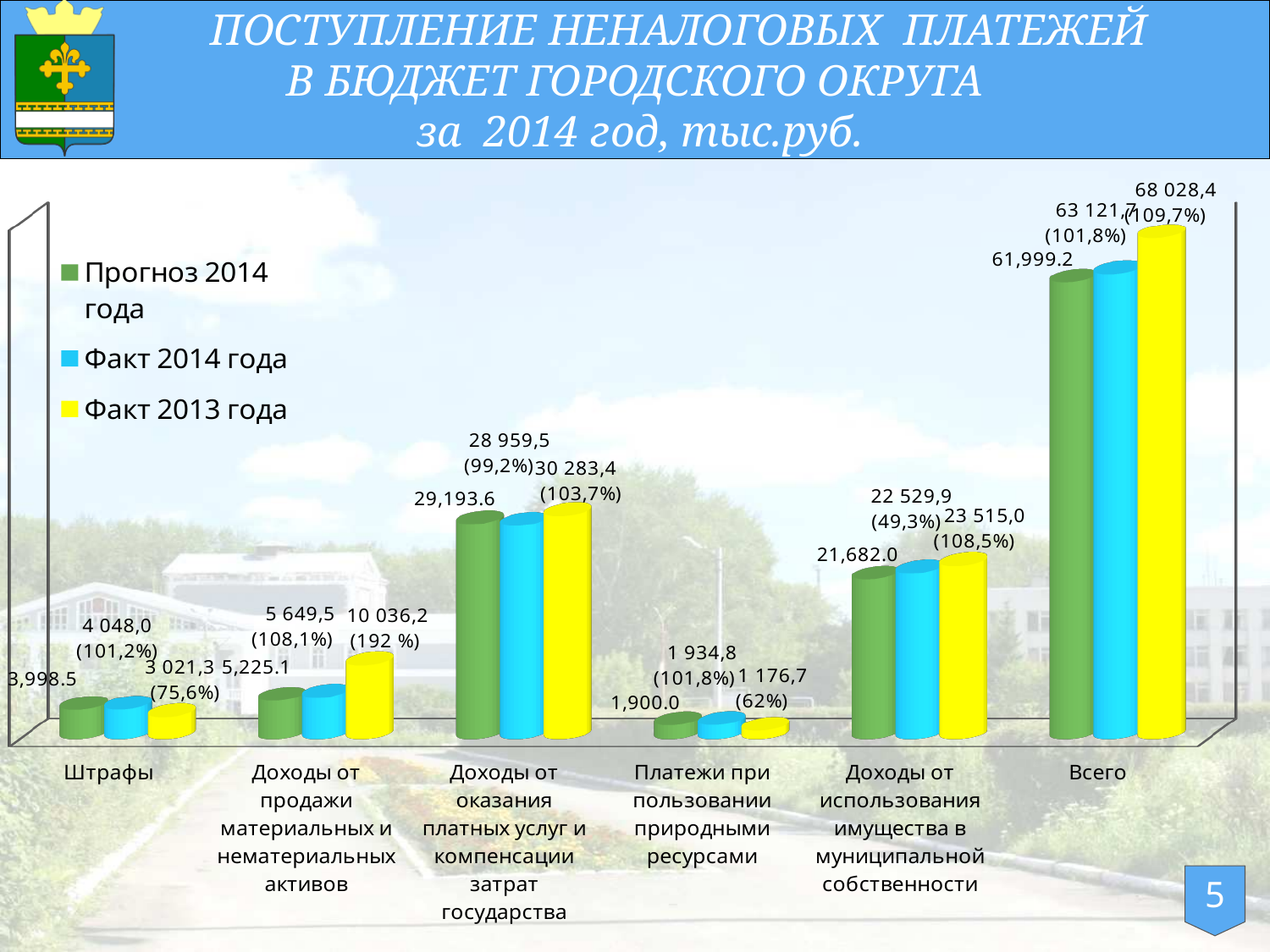
For Доходы от продажи материальных и нематериальных активов, which is larger: Факт 2014 года or Факт 2013 года? Факт 2013 года Excluding Всего, which category has the highest Факт 2013 года value? Доходы от оказания платных услуг и компенсации затрат государства Which category has the lowest Прогноз 2014 года value? Платежи при пользовании природными ресурсами What kind of chart is shown on the slide? bar chart What is the difference between the Факт 2014 года and Факт 2013 года values for Штрафы? 1 026,7 What is the Факт 2014 года value for Штрафы? 4 048,0 How many categories are shown along the x axis? 6 What is the Факт 2013 года value for Доходы от продажи материальных и нематериальных активов? 10 036,2 What is the Прогноз 2014 года value for Доходы от оказания платных услуг и компенсации затрат государства? 29,193.6 How many series does the legend list? 3 What is the Факт 2014 года value for Всего? 63 121,7 What percentage is shown next to the Факт 2013 года value for Платежи при пользовании природными ресурсами? 62%